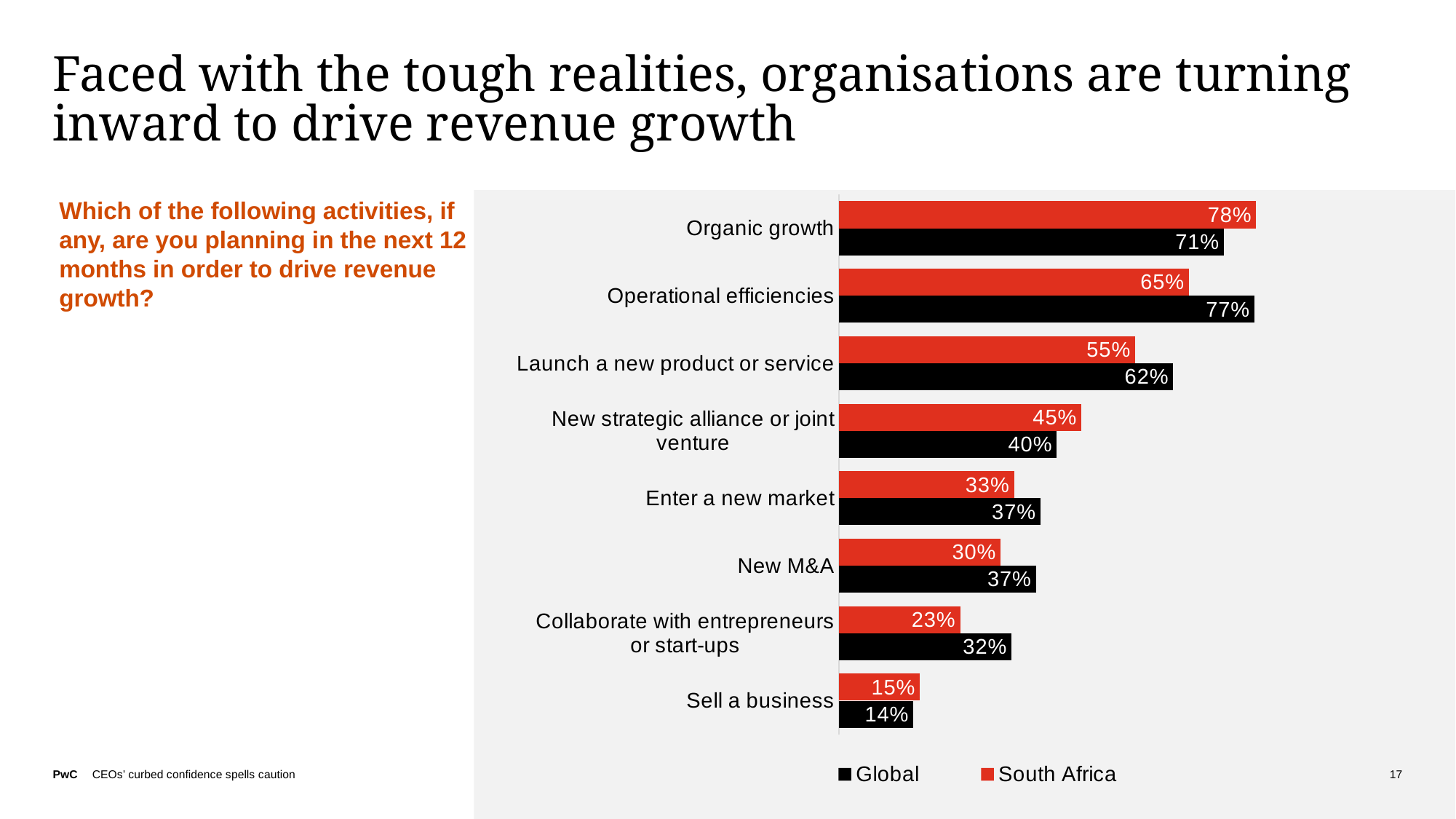
What is the Global value for Collaborate with entrepreneurs or start-ups? 32% For New strategic alliance or joint venture, which is larger: the Global value or the South Africa value? South Africa What kind of chart is shown on the slide? Bar chart What is the Global value for Operational efficiencies? 77% What is the South Africa value for Organic growth? 78% How many series does the legend list? 2 For Launch a new product or service, which is larger: the Global value or the South Africa value? Global What is the difference between the Global and South Africa values for Operational efficiencies? 12% What is the difference between the South Africa and Global values for Organic growth? 7% Which category has the lowest South Africa value? Sell a business How many categories are shown in the chart? 8 Which category has the highest Global value? Operational efficiencies